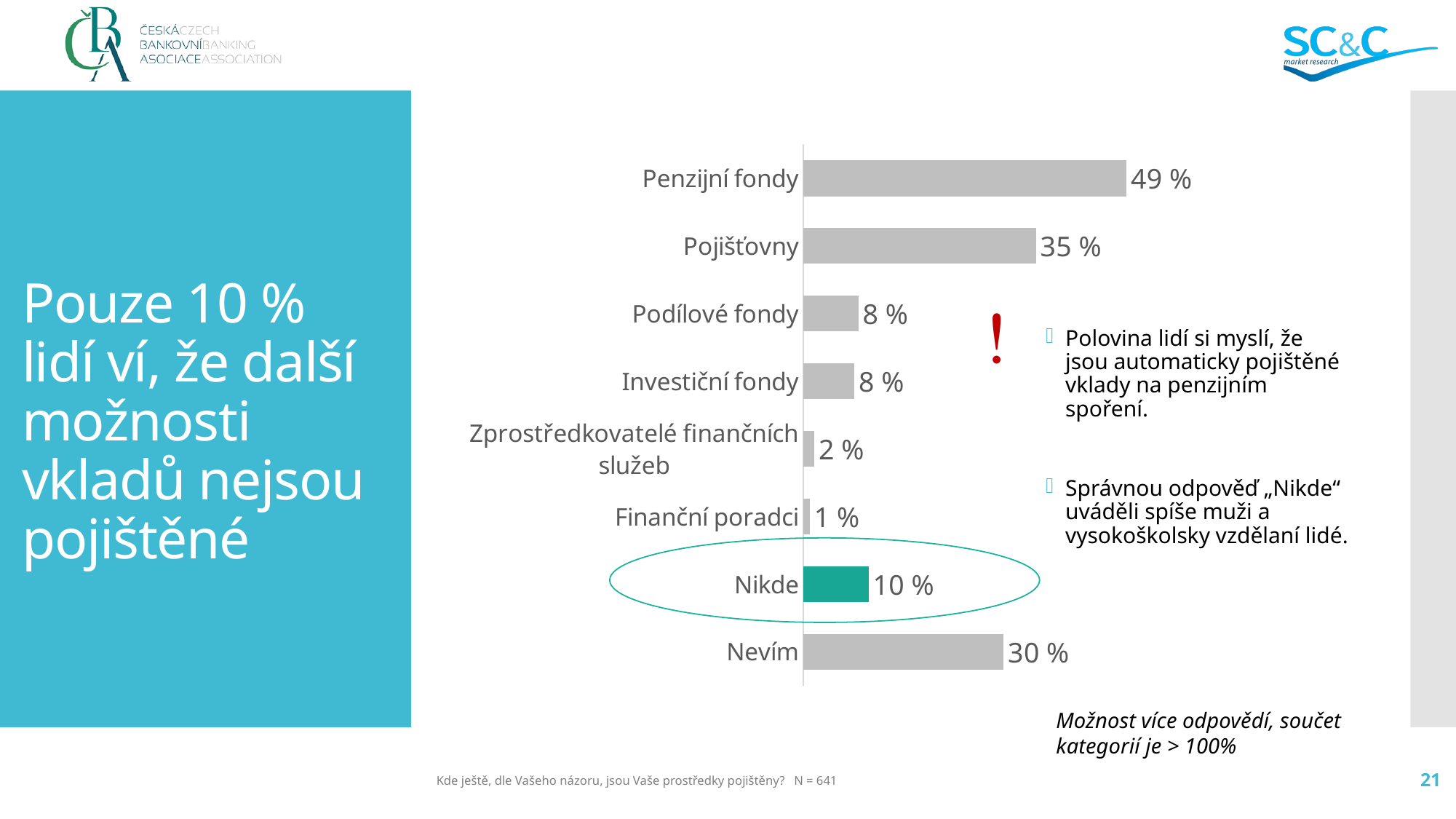
What is the difference between the values for Penzijní fondy and Pojišťovny? 14 % What kind of chart is shown on the slide? Bar chart Which is larger, the value for Nevím or the value for Pojišťovny? Pojišťovny What is the value for Nevím? 30 % What is the difference between the values for Nevím and Nikde? 20 % Which category has the highest value? Penzijní fondy Which category has the lowest value? Finanční poradci What is the value for Nikde? 10 % What is the value for Penzijní fondy? 49 % Which category's bar is coloured green instead of grey? Nikde How many categories are shown in the chart? 8 What is the value for Zprostředkovatelé finančních služeb? 2 %